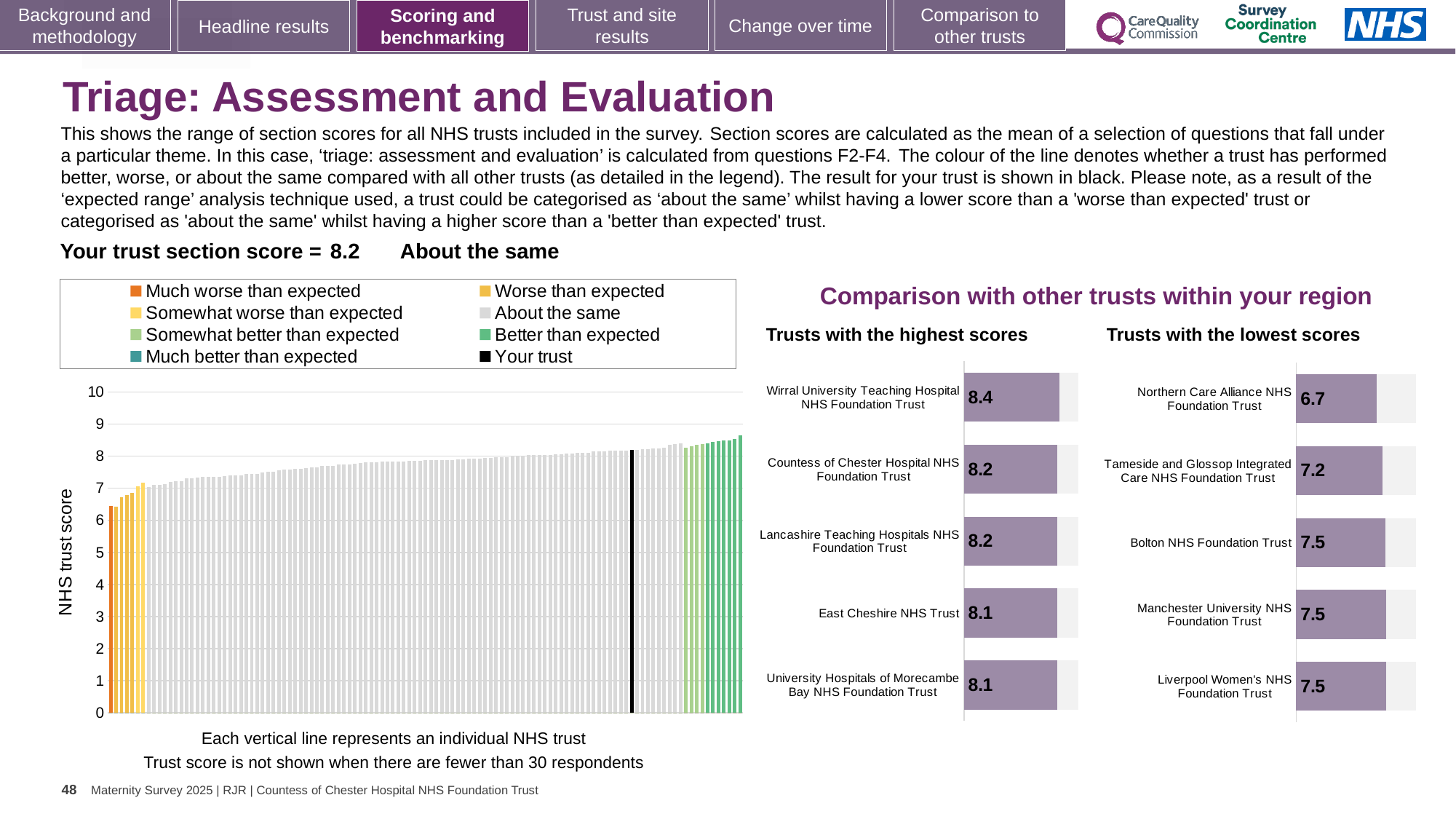
In the main NHS trust score chart, do the values rise or fall from left to right? rise What kind of chart is the main chart on the left showing NHS trust scores? bar chart What is the label on the vertical axis of the main chart on the left? NHS trust score In the 'Trusts with the highest scores' chart, which trust has the highest score? Wirral University Teaching Hospital NHS Foundation Trust In the 'Trusts with the highest scores' chart, what is the difference between the scores of Wirral University Teaching Hospital NHS Foundation Trust and East Cheshire NHS Trust? 0.3 In the 'Trusts with the highest scores' chart, what is the score for Wirral University Teaching Hospital NHS Foundation Trust? 8.4 How many entries does the legend of the main NHS trust score chart list? 8 How many trusts are shown in the 'Trusts with the highest scores' chart? 5 In the 'Trusts with the lowest scores' chart, which has the larger score: Bolton NHS Foundation Trust or Tameside and Glossop Integrated Care NHS Foundation Trust? Bolton NHS Foundation Trust In the 'Trusts with the lowest scores' chart, what is the difference between the scores of Tameside and Glossop Integrated Care NHS Foundation Trust and Northern Care Alliance NHS Foundation Trust? 0.5 In the 'Trusts with the lowest scores' chart, what is the score for Northern Care Alliance NHS Foundation Trust? 6.7 In the 'Trusts with the lowest scores' chart, which trust has the lowest score? Northern Care Alliance NHS Foundation Trust